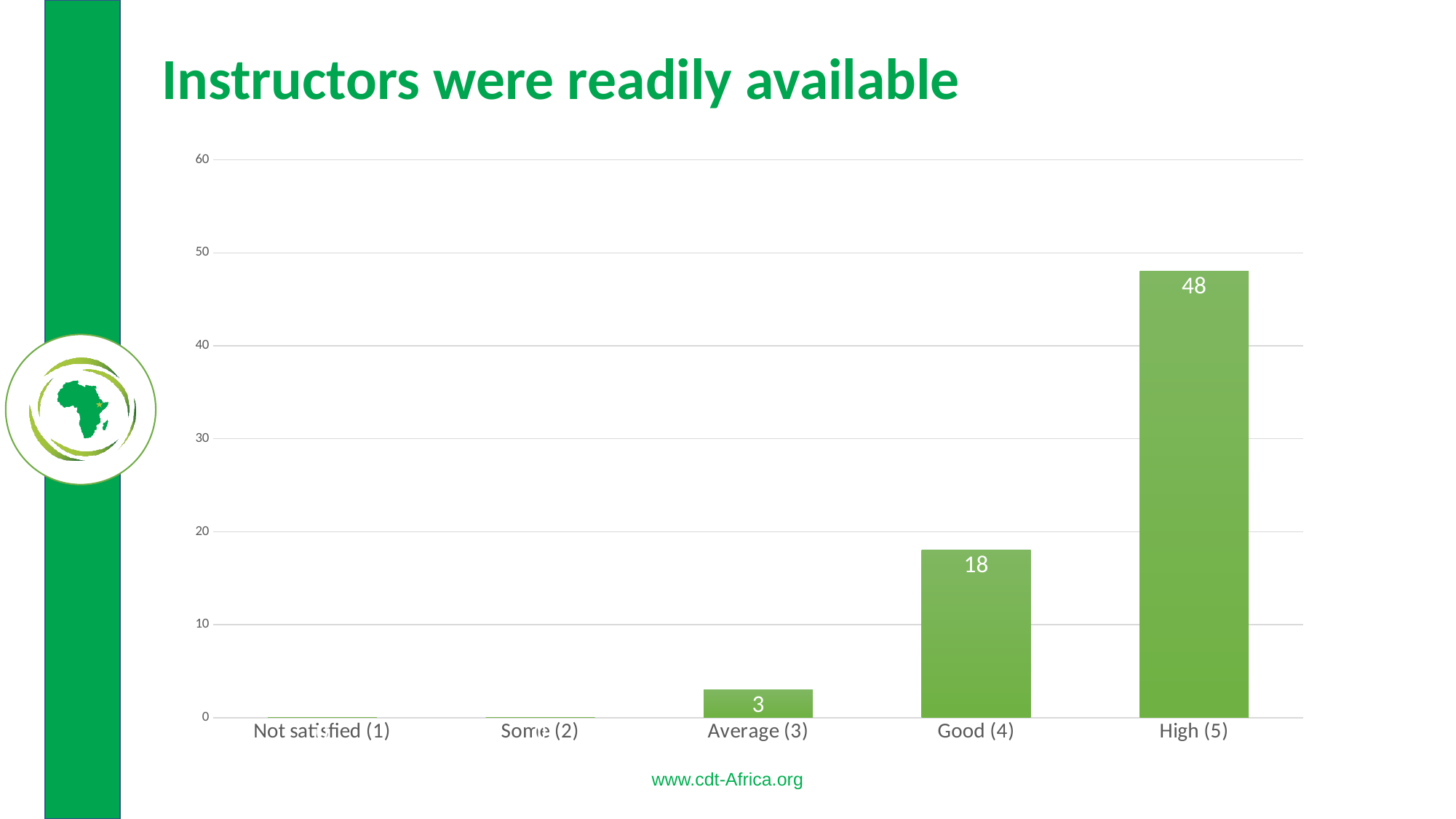
Which category has the highest value? High (5) What is the title of the slide? Instructors were readily available Which is larger, the value for Good (4) or the value for Average (3)? Good (4) What is the value for Good (4)? 18 What is the value for High (5)? 48 Is the value for High (5) greater or less than 40? greater What kind of chart is shown on the slide? Bar chart Is the value for Good (4) greater or less than 20? less What is the difference between the values for Good (4) and Average (3)? 15 How many categories are shown on the x axis? 5 What is the value for Average (3)? 3 What is the difference between the values for High (5) and Good (4)? 30